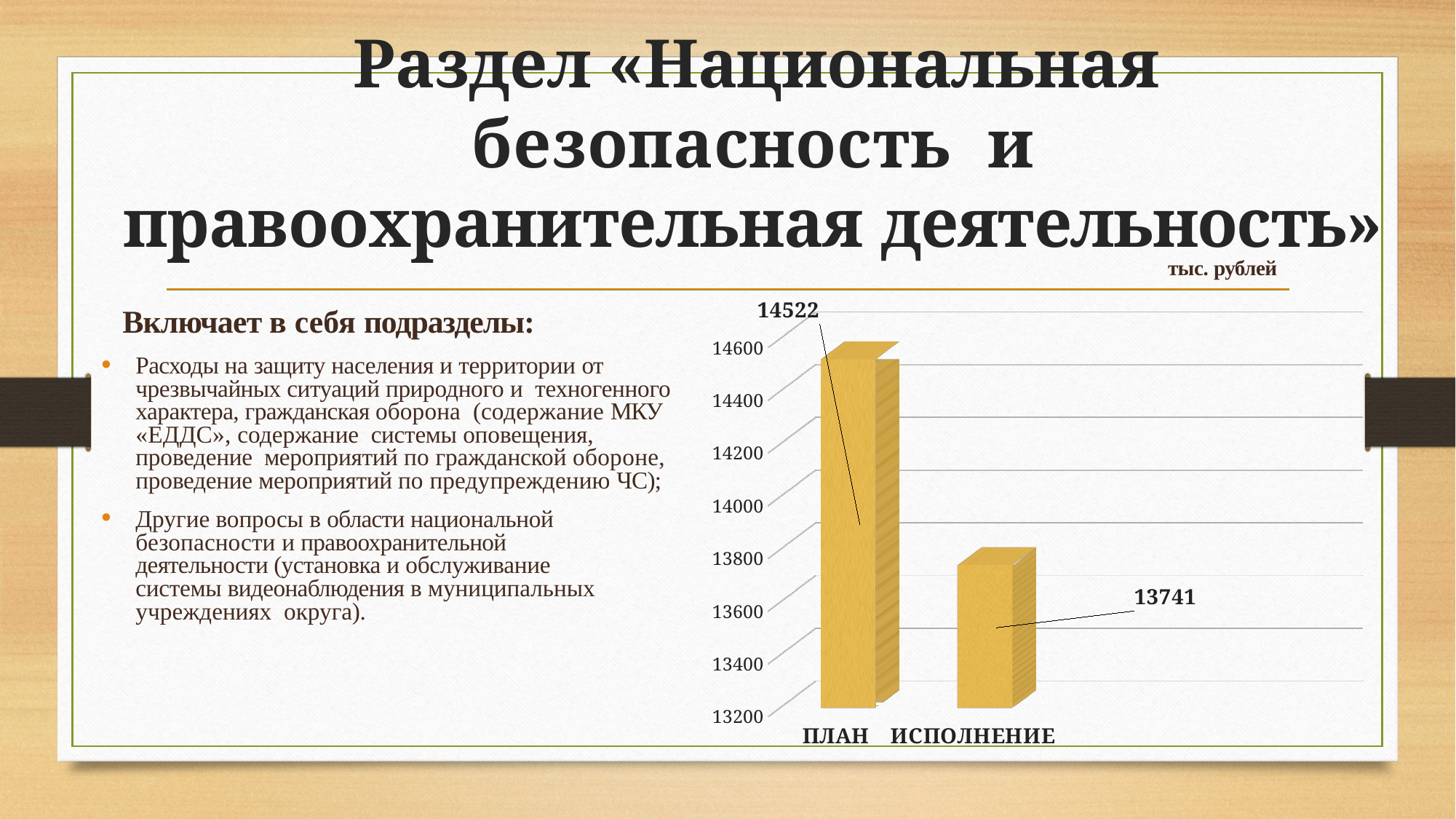
What is the value for ИСПОЛНЕНИЕ? 13741 How many categories are shown in the chart? 2 Which category has the highest value? ПЛАН Which is larger, the value for ПЛАН or the value for ИСПОЛНЕНИЕ? ПЛАН What is the value for ПЛАН? 14522 Do the values rise or fall from ПЛАН to ИСПОЛНЕНИЕ? fall What is the difference between the ПЛАН and ИСПОЛНЕНИЕ values? 781 What unit is indicated above the chart? тыс. рублей Is the value for ПЛАН greater or less than 14400? greater Is the value for ИСПОЛНЕНИЕ greater or less than 14000? less What kind of chart is shown on the slide? bar chart Which category has the lowest value? ИСПОЛНЕНИЕ